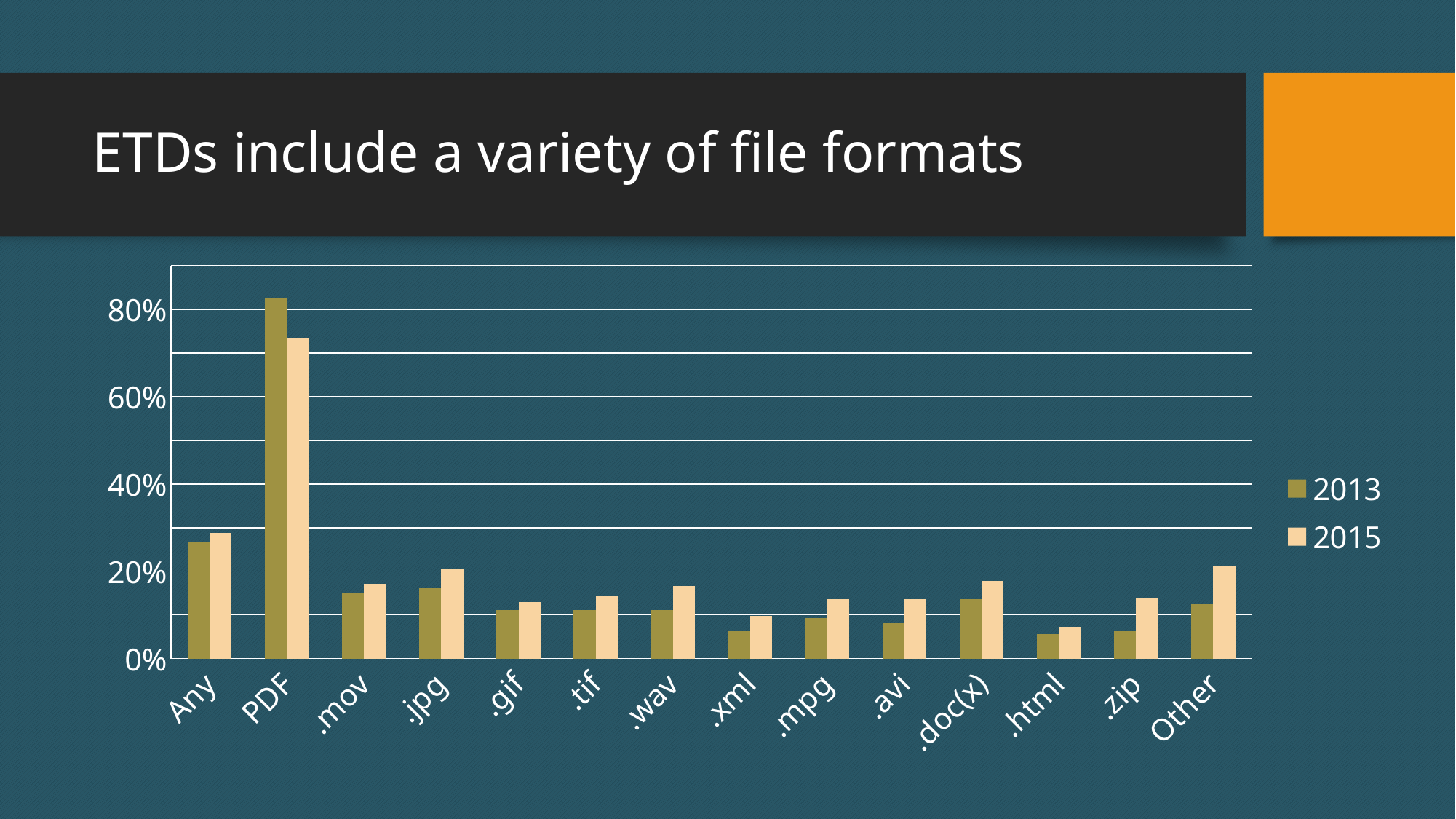
How many series does the legend list? 2 Is the 2015 value for .xml greater or less than 20%? less Which file format has the highest value for 2013? PDF For Other, which year has the larger value, 2013 or 2015? 2015 For PDF, which year has the larger value, 2013 or 2015? 2013 What is the title of the slide containing the chart? ETDs include a variety of file formats Is the 2013 value for Any greater or less than 20%? greater How many file format categories are shown on the x axis? 14 Which file format has the highest value for 2015? PDF What kind of chart is shown on the slide? bar chart Is the 2013 value for PDF greater or less than 60%? greater Which file format has the lowest value for 2015? .html